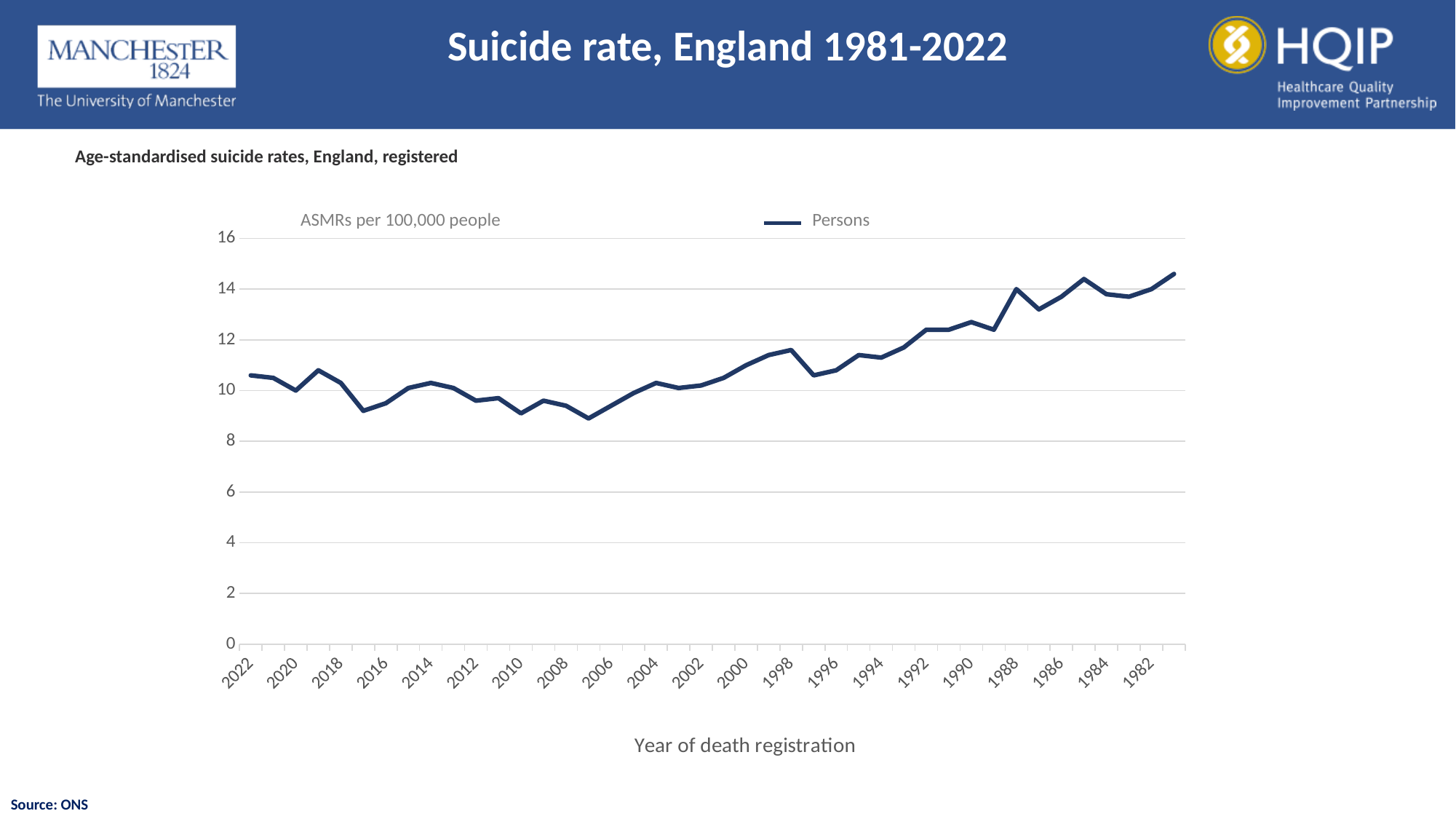
Is the value for 1998 greater or less than 12? less Which year has the larger value, 2022 or 1981? 1981 Which year has the larger value, 2007 or 1998? 1998 What kind of chart is shown on the slide? Line chart What is the name of the series shown in the chart legend? Persons Is the value for 2010 greater or less than 10? less Is the value for 2007 greater or less than 10? less What is the title of the x axis of the chart? Year of death registration How many series does the chart legend list? 1 Reading from left (2022) to right (1981) along the x axis, do the values generally rise or fall? rise